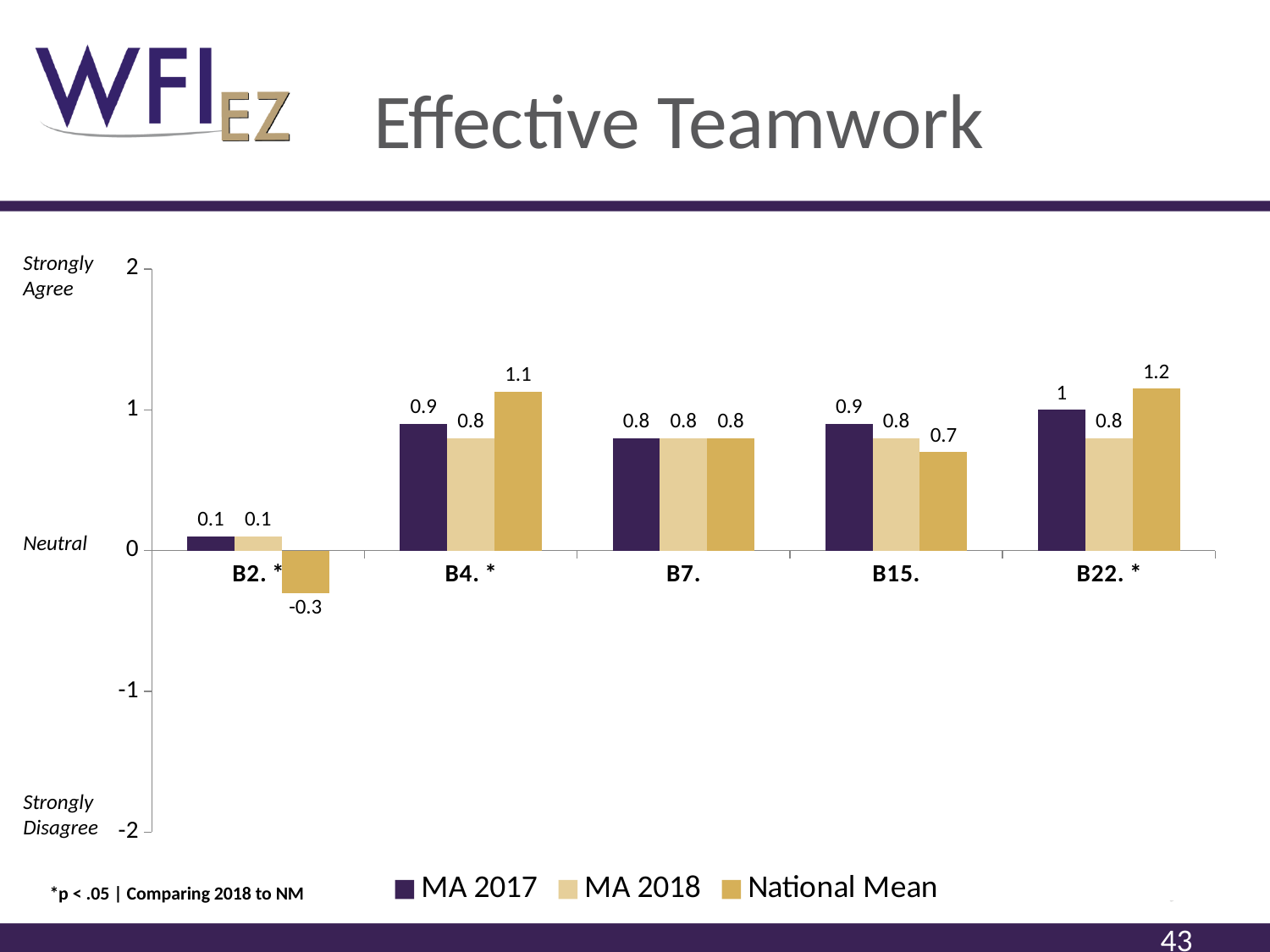
Which category has the highest National Mean value? B22. * What kind of chart is shown on the slide? Bar chart Which is larger for B4. *: the MA 2017 value or the National Mean value? National Mean What is the National Mean value for B2. *? -0.3 Which category has the lowest MA 2018 value? B2. * What is the total of the three values for B7.? 2.4 What is the difference between the National Mean and MA 2018 values for B22. *? 0.4 What is the MA 2017 value for B22. *? 1 What is the National Mean value for B15.? 0.7 What is the title of the slide? Effective Teamwork How many categories are shown on the x axis? 5 How many series does the legend list? 3